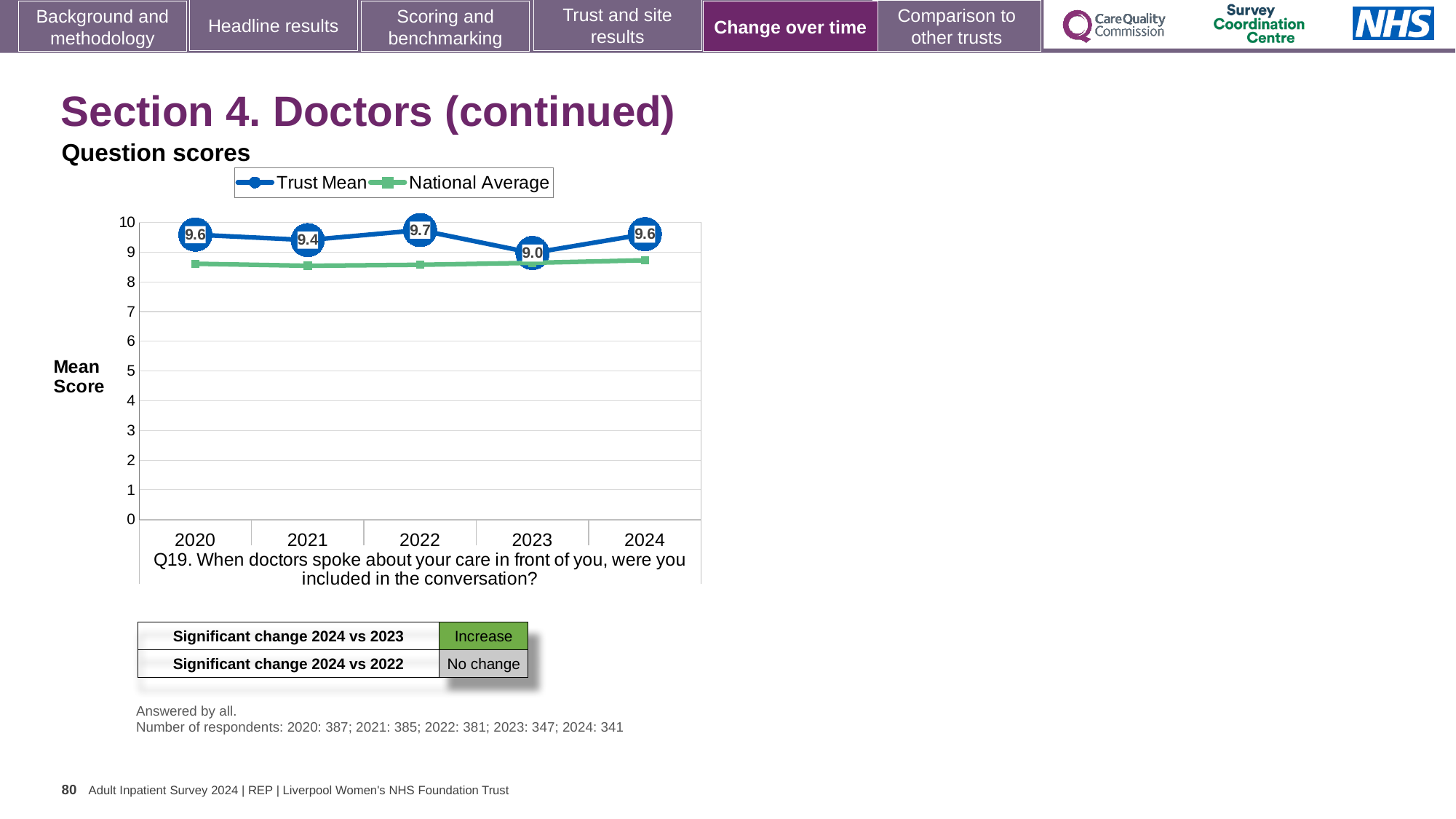
In which year is the Trust Mean score highest? 2022 Is the National Average value for 2024 greater or less than 9? less What is the Trust Mean score for 2023? 9.0 Which is larger, the Trust Mean score for 2021 or for 2024? 2024 How many years are shown on the x axis of the chart? 5 What kind of chart is shown on the slide? line chart In which year is the Trust Mean score lowest? 2023 What is the Trust Mean score for 2022? 9.7 What is the Trust Mean score for 2020? 9.6 Which survey question does the chart relate to? Q19. When doctors spoke about your care in front of you, were you included in the conversation? What is the difference between the Trust Mean scores for 2022 and 2023? 0.7 How many series does the chart legend list? 2